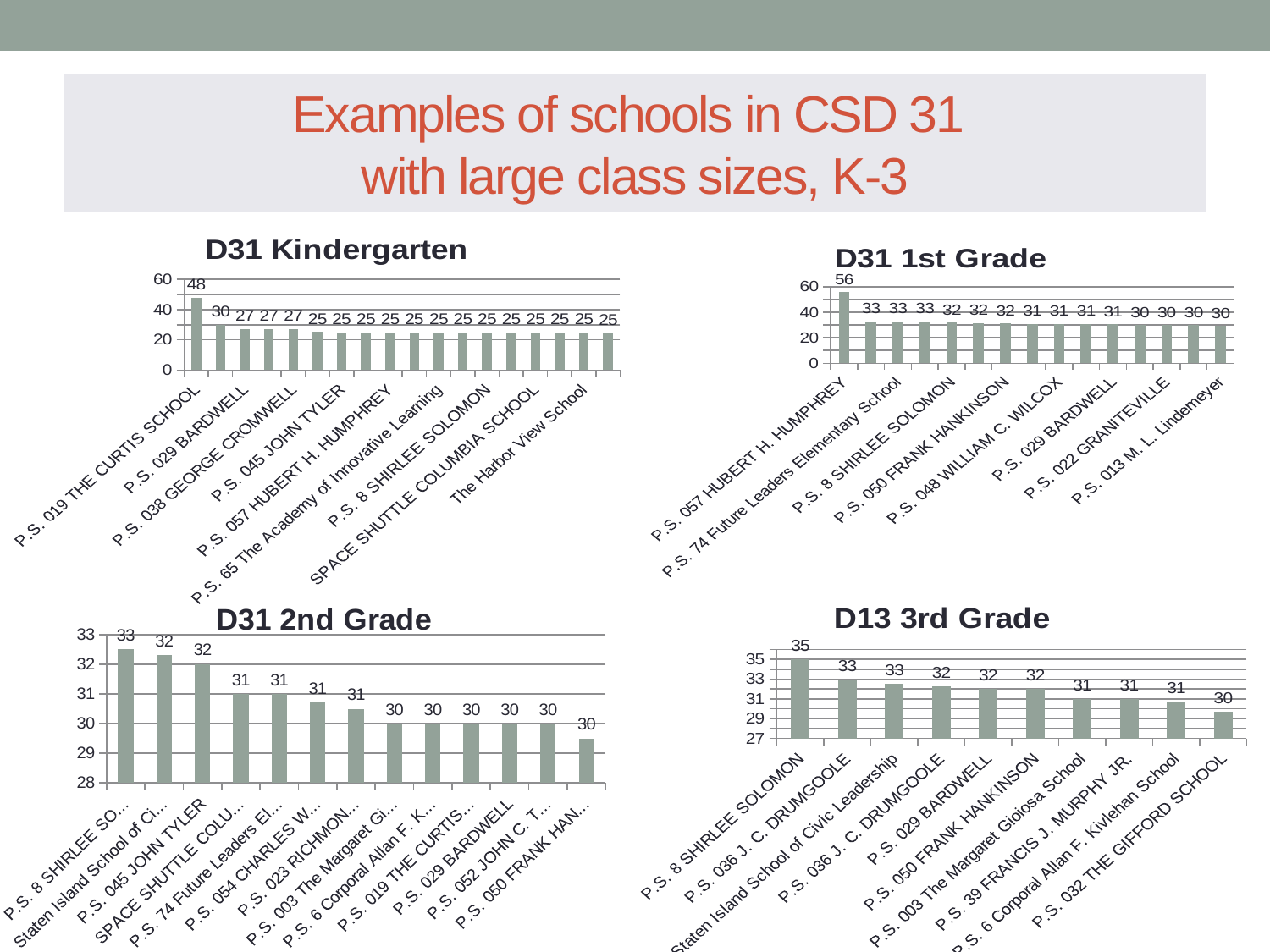
In the D13 3rd Grade chart, what is the difference between P.S. 8 SHIRLEE SOLOMON and P.S. 032 THE GIFFORD SCHOOL? 5 In the D13 3rd Grade chart, what is the value for P.S. 8 SHIRLEE SOLOMON? 35 In the D31 1st Grade chart, how many bars are plotted? 15 In the D31 Kindergarten chart, how many bars are plotted? 18 In the D13 3rd Grade chart, which school has the lowest value? P.S. 032 THE GIFFORD SCHOOL In the D31 2nd Grade chart, what is the value for P.S. 045 JOHN TYLER? 32 In the D31 2nd Grade chart, how many schools are plotted? 13 In the D31 Kindergarten chart, what is the value for P.S. 019 THE CURTIS SCHOOL? 48 In the D31 Kindergarten chart, which school has the highest value? P.S. 019 THE CURTIS SCHOOL What kind of chart is the D13 3rd Grade chart? Bar chart In the D31 1st Grade chart, what is the value for P.S. 057 HUBERT H. HUMPHREY? 56 In the D31 1st Grade chart, what is the difference between the highest value (56) and the lowest value (30)? 26